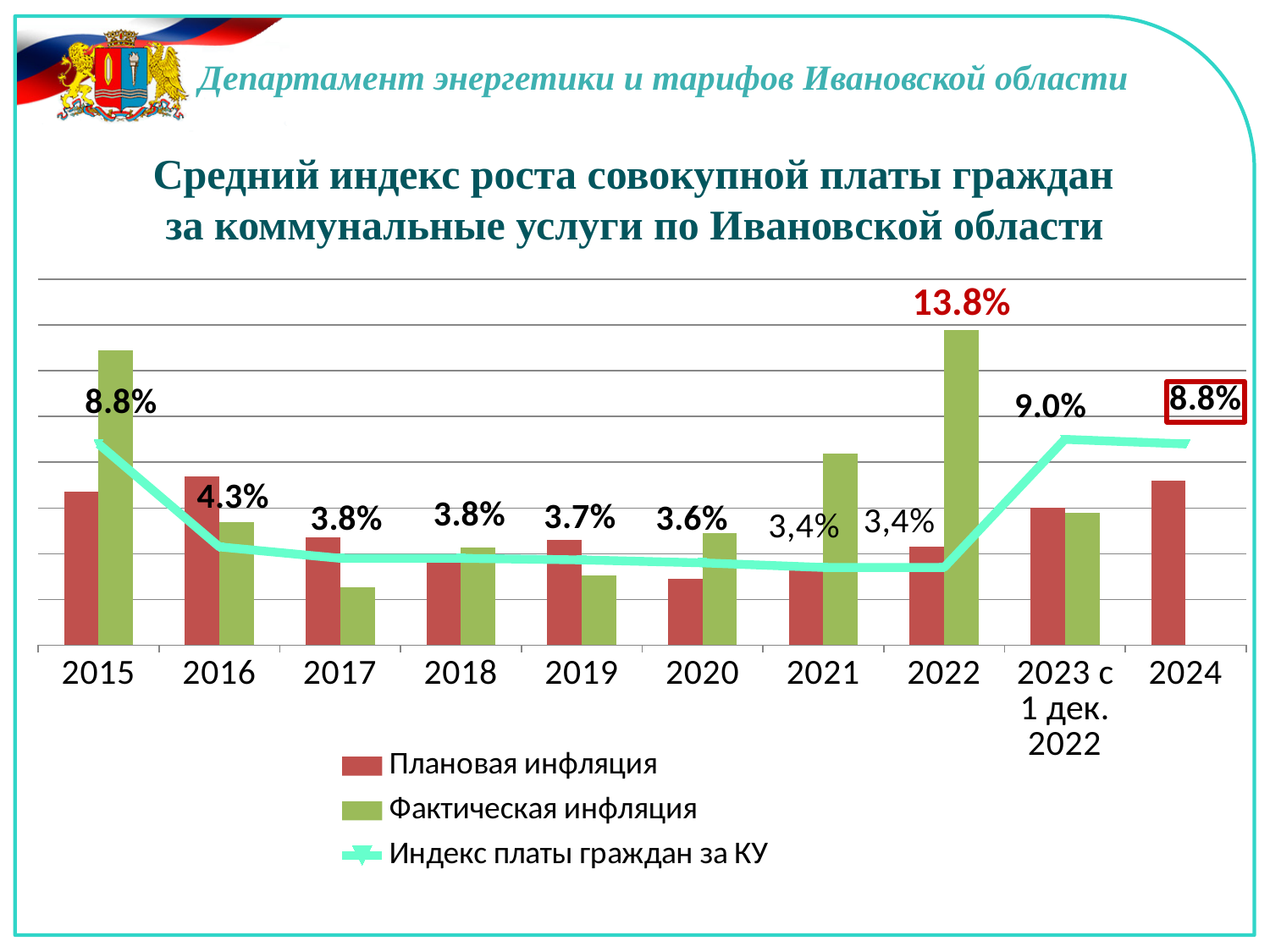
How many series does the legend list? 3 What value is labelled in red above the actual inflation (Фактическая инфляция) bar for 2022? 13.8% What is the value of the citizens' utility payment index for 2024? 8.8% What is the difference between the citizens' utility payment index for 2015 (8.8%) and for 2016 (4.3%)? 4.5% In which year is the planned inflation (Плановая инфляция) bar the lowest? 2020 How many categories are shown on the x axis? 10 What is the value of the citizens' utility payment index (Индекс платы граждан за КУ) for 2015? 8.8% In which year is the actual inflation (Фактическая инфляция) bar the highest? 2022 Does the citizens' utility payment index rise or fall from 2015 to 2020? fall What is the value of the citizens' utility payment index for 2021? 3,4% What is the value of the citizens' utility payment index for 2016? 4.3% What is the value of the citizens' utility payment index for 2020? 3.6%